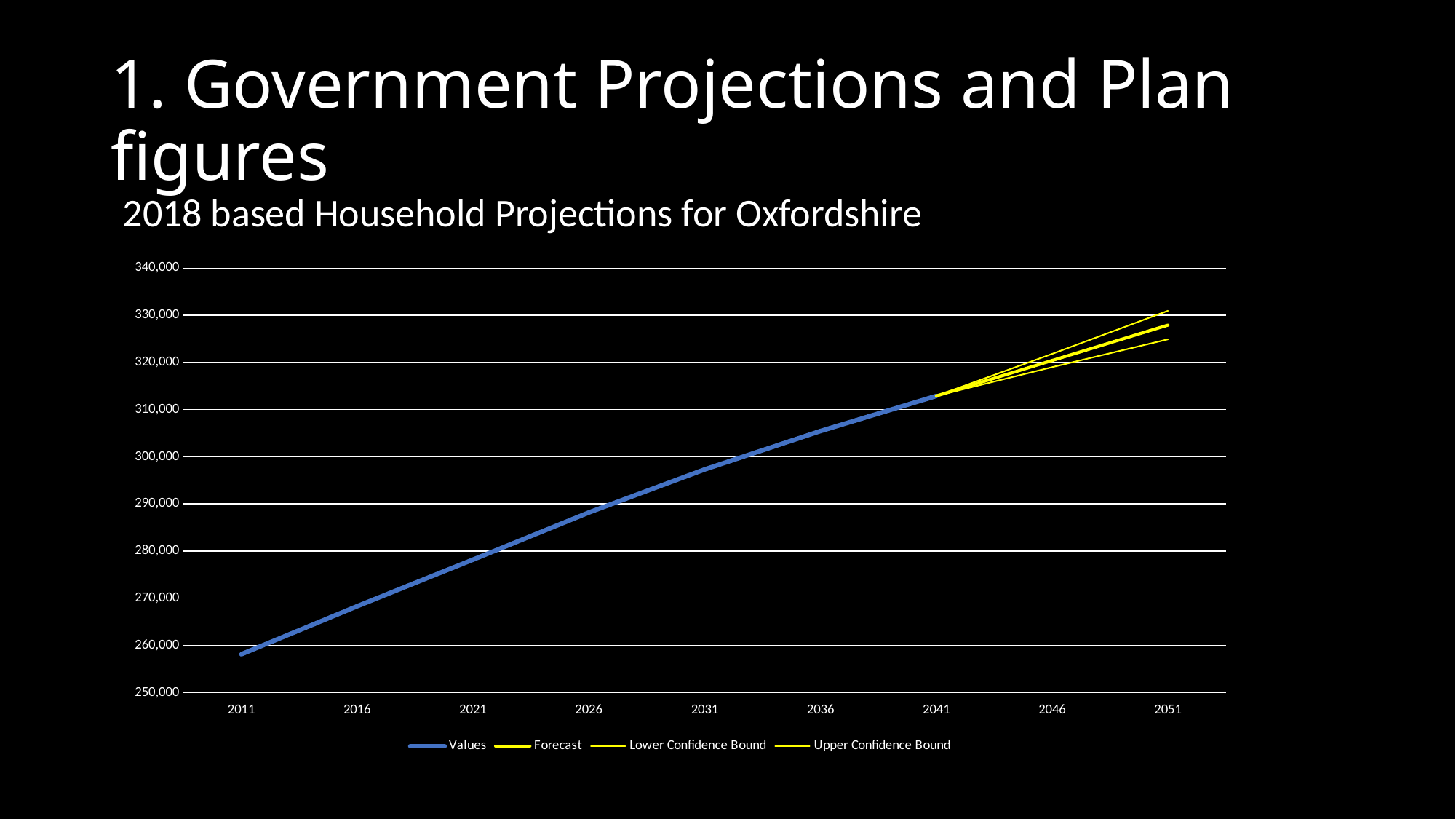
How many year labels are shown on the x axis? 9 Which series reaches the highest point in 2051? Upper Confidence Bound Is the value for 2041 greater or less than 310,000? greater Is the Forecast value for 2051 greater or less than 320,000? greater Do the Values rise or fall from 2011 to 2041? rise What is the title of the chart? 2018 based Household Projections for Oxfordshire Which series is drawn in blue? Values How many series does the chart legend list? 4 Is the value for 2011 greater or less than 260,000? less Which is larger, the value for 2011 or the value for 2041? 2041 What kind of chart is shown on the slide? line chart